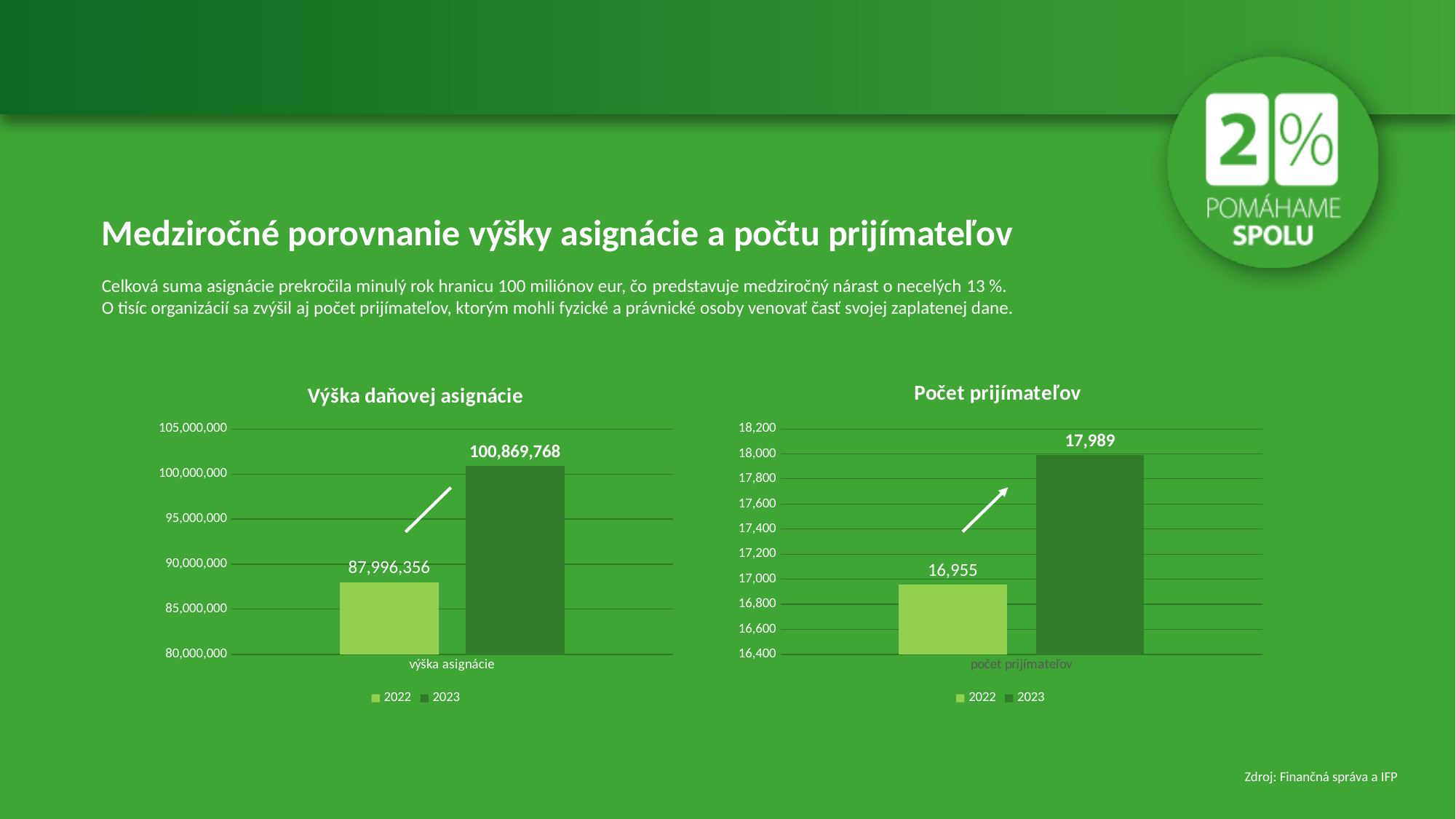
In the chart titled 'Počet prijímateľov', which year has the higher value, 2022 or 2023? 2023 In the chart titled 'Výška daňovej asignácie', what is the value for 2023? 100,869,768 In the chart titled 'Počet prijímateľov', what is the value for 2023? 17,989 In the chart titled 'Počet prijímateľov', is the value for 2022 greater or less than 17,000? less What is the title of the chart on the left side of the slide? Výška daňovej asignácie What kind of chart is the chart titled 'Počet prijímateľov'? bar chart How many series does the legend of the chart titled 'Výška daňovej asignácie' list? 2 In the chart titled 'Výška daňovej asignácie', what is the value for 2022? 87,996,356 In the chart titled 'Výška daňovej asignácie', what is the difference between the 2023 and 2022 values? 12,873,412 In the chart titled 'Výška daňovej asignácie', is the value for 2023 greater or less than 100,000,000? greater In the chart titled 'Počet prijímateľov', what is the difference between the 2023 and 2022 values? 1,034 In the chart titled 'Počet prijímateľov', what is the value for 2022? 16,955